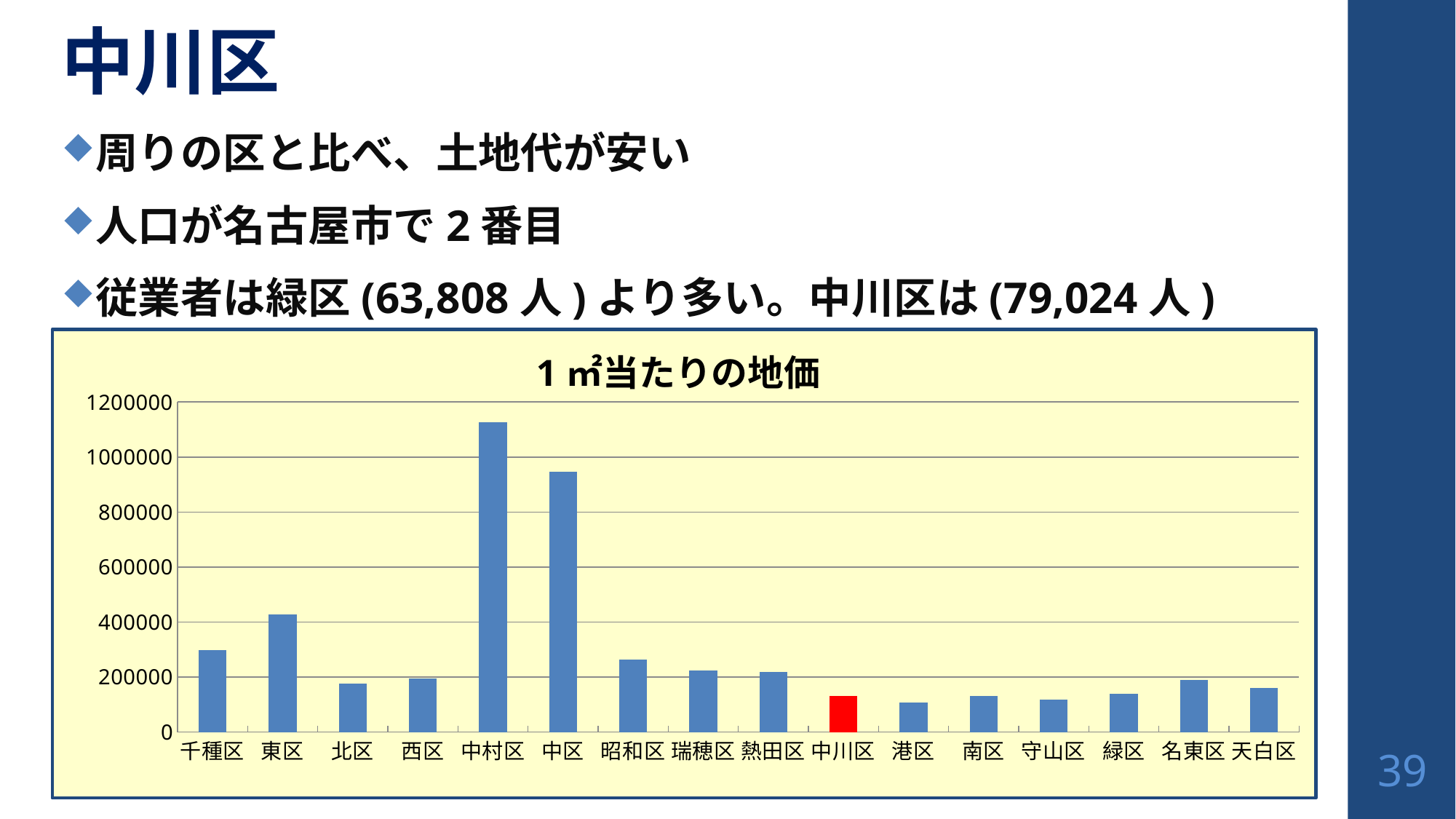
Which has the larger value, 中村区 or 中区? 中村区 What is the title of the chart? 1㎡当たりの地価 Which has the larger value, 東区 or 千種区? 東区 How many wards (categories) are shown on the x axis of the chart? 16 Is the value for 東区 greater or less than 400000? greater Is the value for 中村区 greater or less than 1000000? greater What kind of chart is shown on the slide? bar chart Is the value for 中川区 greater or less than 200000? less Which has the larger value, 昭和区 or 中川区? 昭和区 Which bar in the chart is coloured red? 中川区 Which ward has the highest land price per square metre in the chart? 中村区